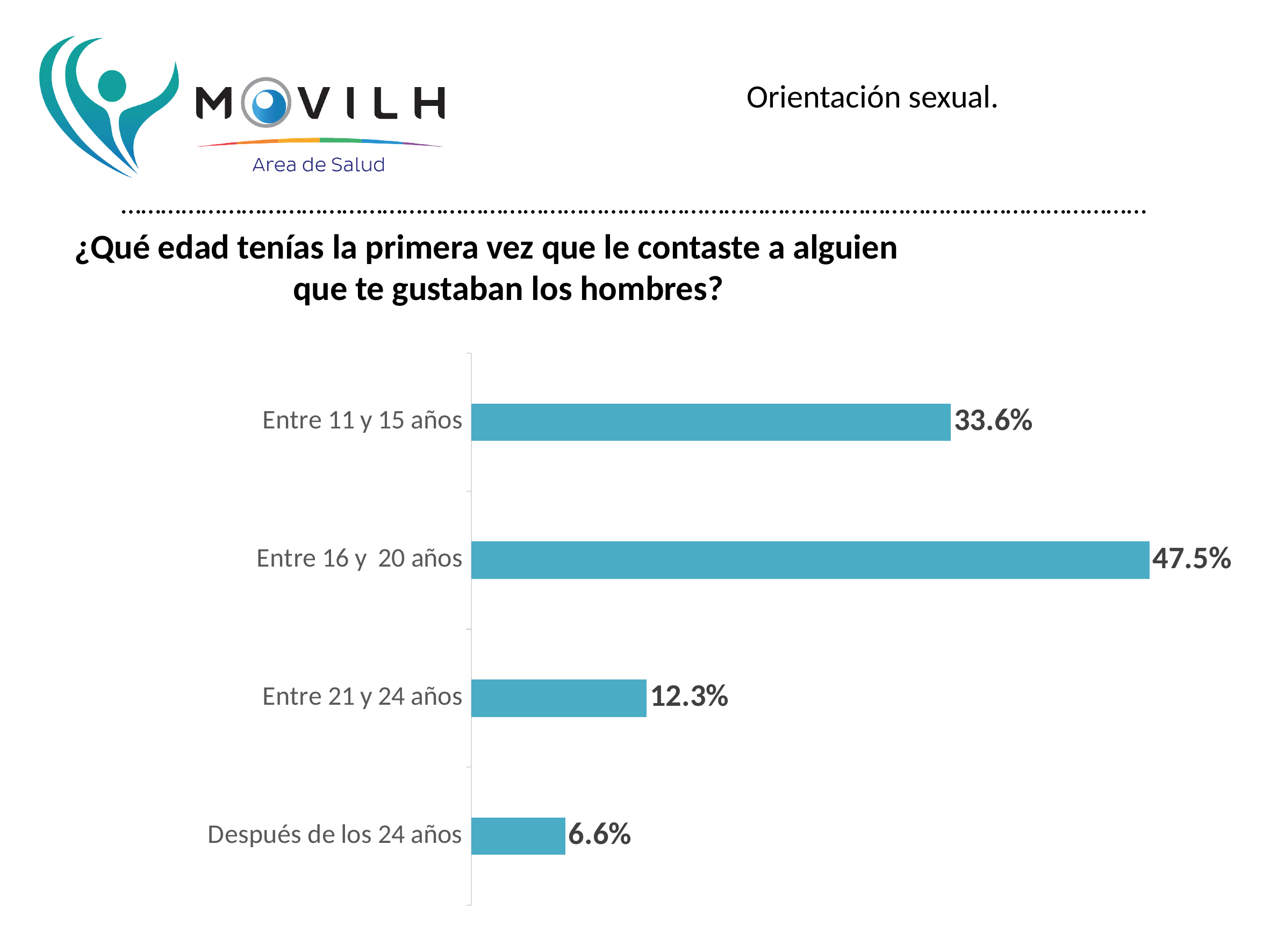
How many categories are shown in the chart? 4 What is the value for "Entre 16 y 20 años"? 47.5% What is the difference between the values for "Entre 16 y 20 años" and "Entre 11 y 15 años"? 13.9% What is the value for "Entre 11 y 15 años"? 33.6% What is the value for "Entre 21 y 24 años"? 12.3% Which is larger, the value for "Entre 11 y 15 años" or the value for "Entre 21 y 24 años"? Entre 11 y 15 años What is the difference between the values for "Entre 21 y 24 años" and "Después de los 24 años"? 5.7% What is the value for "Después de los 24 años"? 6.6% What question does the chart title ask? ¿Qué edad tenías la primera vez que le contaste a alguien que te gustaban los hombres? What kind of chart is shown on the slide? Bar chart Which category has the lowest value? Después de los 24 años Which category has the highest value? Entre 16 y 20 años